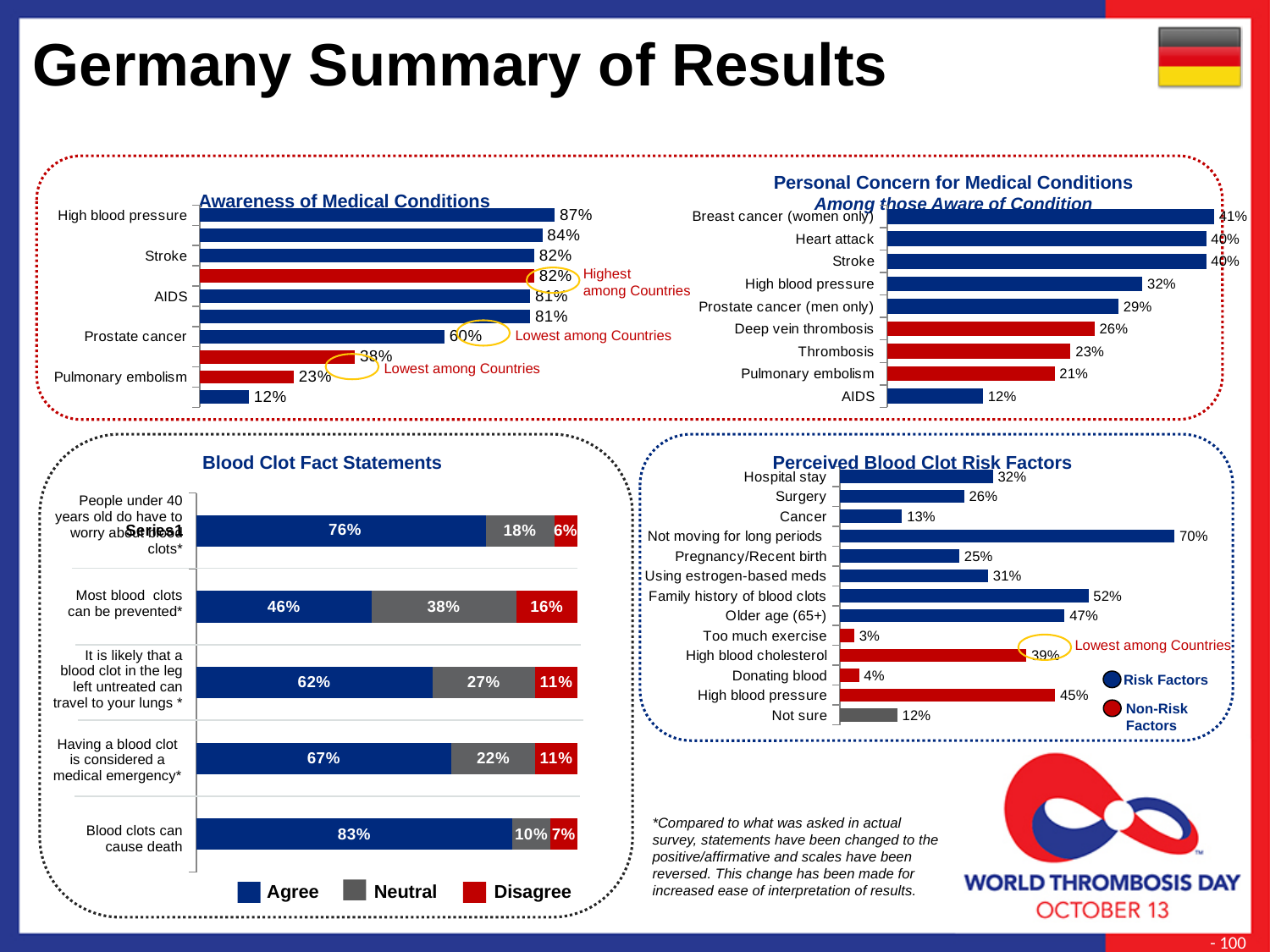
In the Personal Concern for Medical Conditions chart, how many conditions are listed? 9 In the Perceived Blood Clot Risk Factors chart, which factor has the lowest value? Too much exercise In the Personal Concern for Medical Conditions chart, which condition has the lowest value? AIDS In the Awareness of Medical Conditions chart, what is the awareness value for High blood pressure? 87% How many series does the legend of the Blood Clot Fact Statements chart list? 3 In the Personal Concern for Medical Conditions chart, what is the difference between High blood pressure and Pulmonary embolism? 11% In the Perceived Blood Clot Risk Factors chart, which is larger: Family history of blood clots or Older age (65+)? Family history of blood clots In the Awareness of Medical Conditions chart, what is the value for Pulmonary embolism? 23% In the Blood Clot Fact Statements chart, what is the Neutral share for 'Most blood clots can be prevented'? 38% In the Blood Clot Fact Statements chart, what percentage agree that blood clots can cause death? 83% In the Perceived Blood Clot Risk Factors chart, which factor has the highest value? Not moving for long periods In the Personal Concern for Medical Conditions chart, what is the value for Deep vein thrombosis? 26%